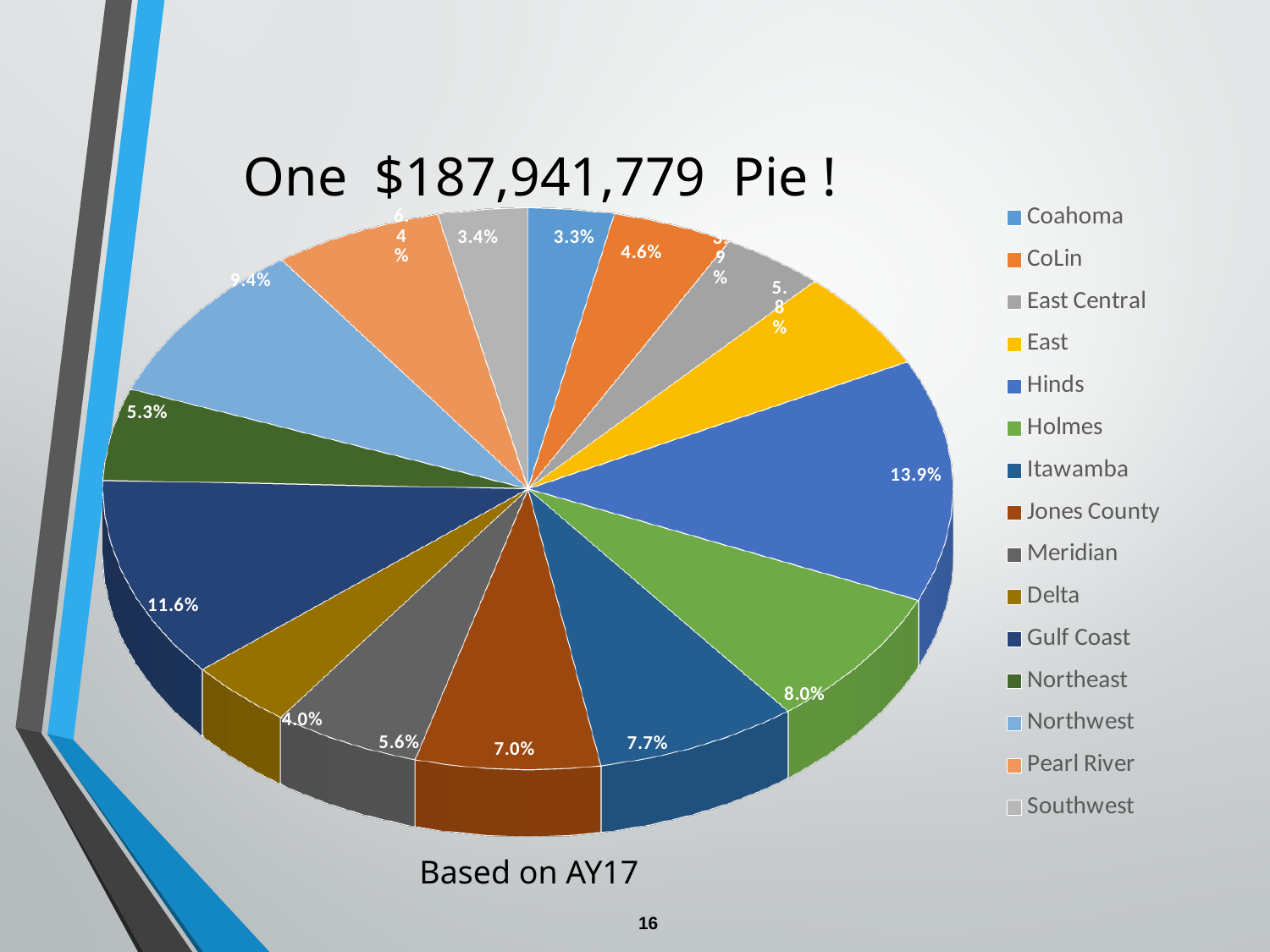
Which has a larger share, Holmes or Itawamba? Holmes What is the difference between the shares of Hinds and Gulf Coast? 2.3% What share of the pie does Hinds have? 13.9% How many categories does the legend list? 15 What kind of chart is shown on the slide? pie chart What share of the pie does Gulf Coast have? 11.6% Which category has the largest share of the pie? Hinds What share of the pie does Northwest have? 9.4% What share of the pie does Delta have? 4.0% What is the title of the chart? One $187,941,779 Pie ! What share of the pie does Jones County have? 7.0% What academic year is the chart based on, according to the note below it? AY17